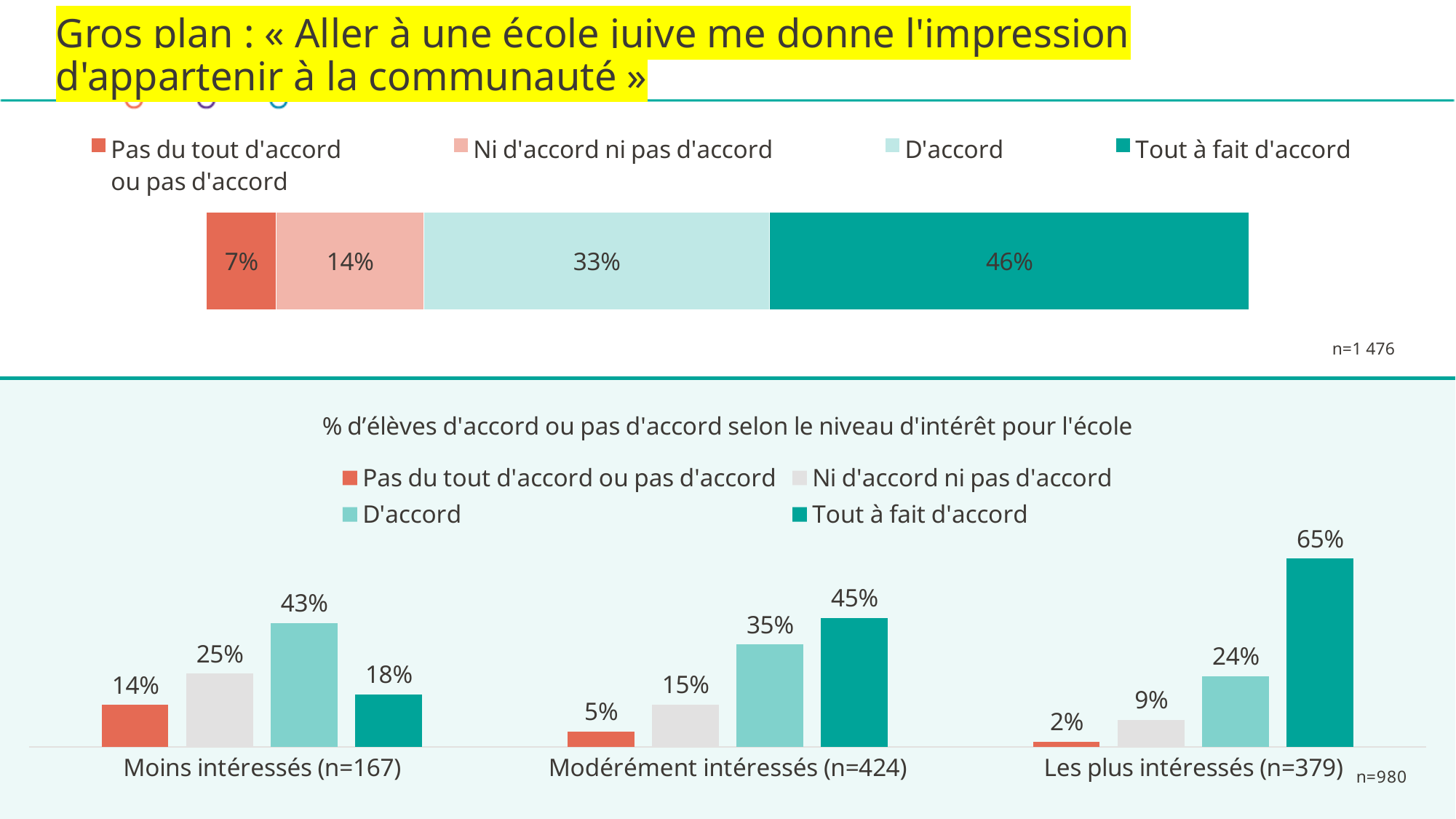
In the bottom chart, how many interest-level groups are shown on the x axis? 3 In the bottom chart, what is the "Pas du tout d'accord ou pas d'accord" value for "Modérément intéressés (n=424)"? 5% In the bottom chart "% d'élèves d'accord ou pas d'accord selon le niveau d'intérêt pour l'école", what is the "Tout à fait d'accord" value for "Les plus intéressés (n=379)"? 65% In the top stacked bar chart, what percentage answered "Ni d'accord ni pas d'accord"? 14% In the bottom chart, how many series does the legend list? 4 In the bottom chart, does the "Tout à fait d'accord" value rise or fall from "Moins intéressés" to "Les plus intéressés"? rise In the bottom chart, what is the "D'accord" value for "Moins intéressés (n=167)"? 43% In the bottom chart, which group has the highest "Tout à fait d'accord" value? Les plus intéressés (n=379) In the top stacked bar chart, what percentage of students answered "Tout à fait d'accord"? 46% In the top stacked bar chart, which response category has the smallest share? Pas du tout d'accord ou pas d'accord In the top stacked bar chart, what is the difference between the "Tout à fait d'accord" and "D'accord" shares? 13% In the top stacked bar chart, what sample size (n) is shown? n=1 476